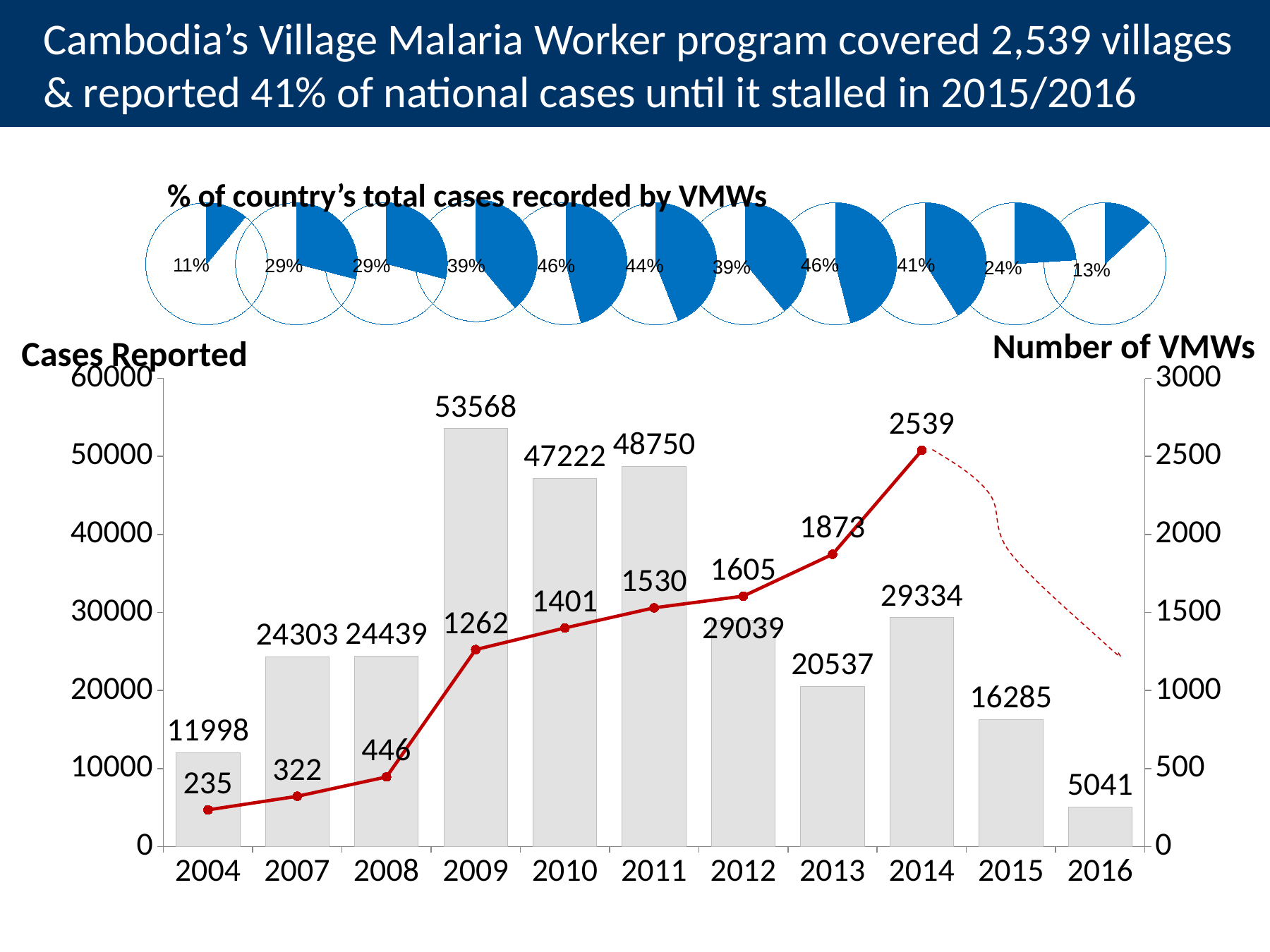
In the main chart, how many cases were reported in 2009? 53568 In the main chart, what is the difference between cases reported in 2011 and in 2010? 1528 In the main chart, which year had more cases reported, 2007 or 2008? 2008 In the main chart, by how much did the number of VMWs increase from 2013 to 2014? 666 In the main chart, what was the number of VMWs in 2014? 2539 In the main chart, how many years are shown on the x axis? 11 In the main chart, which year has the highest number of cases reported? 2009 In the main chart, which year has the lowest number of cases reported? 2016 In the row of pie charts titled '% of country's total cases recorded by VMWs', what share is shown in the first (leftmost) pie? 11% In the main chart, what was the number of VMWs in 2008? 446 What is the title of the right-hand axis of the main chart? Number of VMWs In the main chart, does the number of VMWs rise or fall from 2004 to 2014? rise